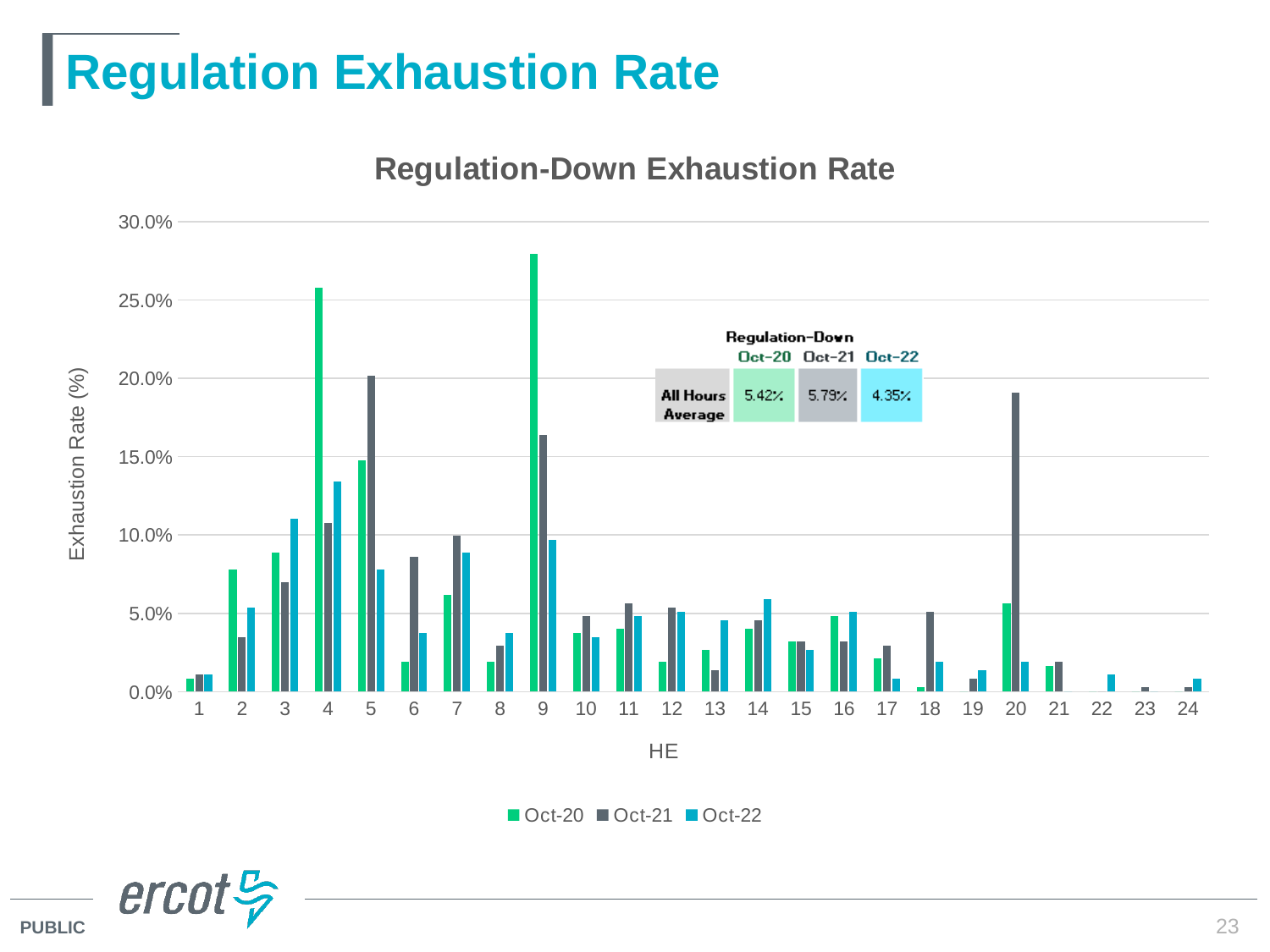
Is the Oct-22 value at HE 3 greater or less than 10.0%? greater At which HE is the Oct-21 exhaustion rate highest? 5 How many hour-ending (HE) categories are shown on the x axis? 24 At which HE is the Oct-20 exhaustion rate highest? 9 How many series does the legend list? 3 At HE 5, which series has the larger value, Oct-20 or Oct-21? Oct-21 According to the inset table, what is the All Hours Average Regulation-Down exhaustion rate for Oct-21? 5.79% Is the Oct-21 value at HE 20 greater or less than 15.0%? greater According to the inset table, what is the All Hours Average Regulation-Down exhaustion rate for Oct-22? 4.35% Is the Oct-20 value at HE 4 greater or less than 25.0%? greater What is the title of the chart? Regulation-Down Exhaustion Rate What kind of chart is shown on the slide? bar chart